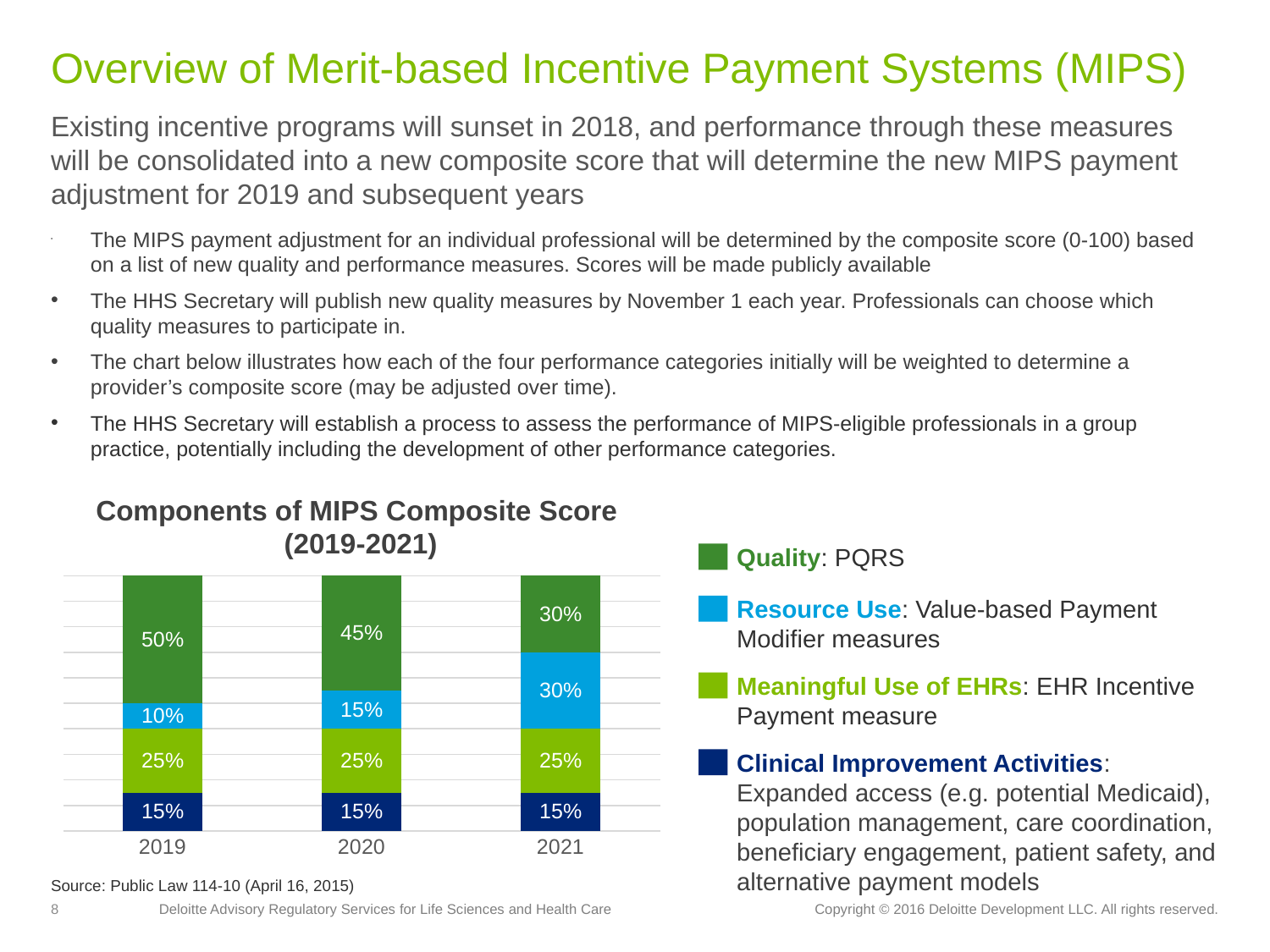
By how many percentage points does the Quality share fall from 2019 to 2021? 20 percentage points What type of chart is shown under the title "Components of MIPS Composite Score (2019-2021)"? Stacked bar chart How many components does the legend list for the MIPS composite score? 4 What is the Clinical Improvement Activities share of the MIPS composite score in 2021? 15% Does the Quality share of the composite score rise or fall from 2019 to 2021? Fall What is the Meaningful Use of EHRs share of the MIPS composite score in 2021? 25% Which is larger in 2020: the Quality share or the Resource Use share? Quality How many years are shown on the x axis of the chart? 3 In which year is the Quality share of the composite score the lowest? 2021 In which year is the Resource Use share of the composite score the highest? 2021 What is the Resource Use share of the MIPS composite score in 2020? 15% What is the Quality share of the MIPS composite score in 2019? 50%